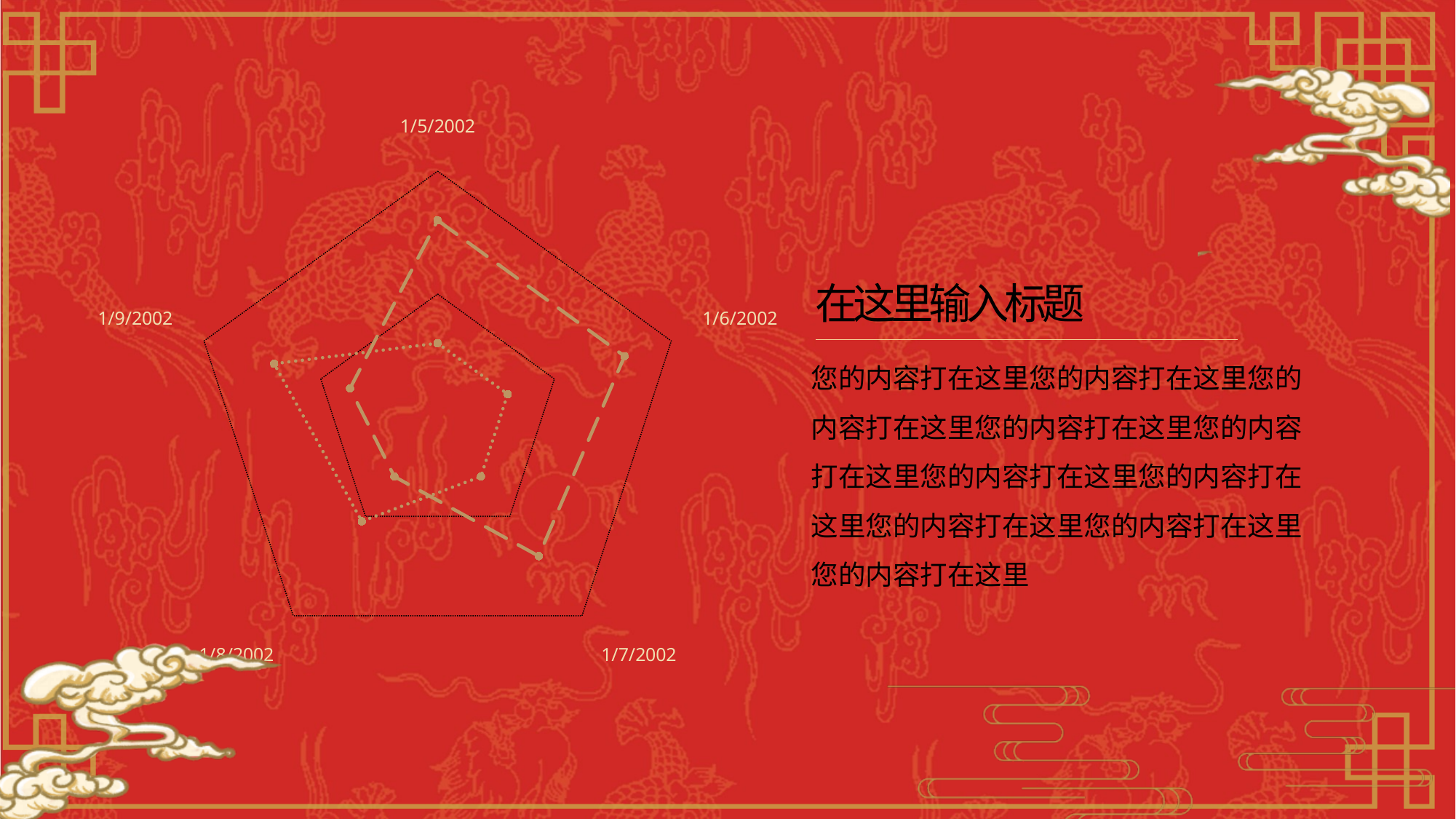
In which category does the dotted-line series reach its highest value? 1/9/2002 For the category 1/8/2002, which series has the larger value: the dashed-line series or the dotted-line series? The dotted-line series For the category 1/5/2002, which series has the larger value: the dashed-line series or the dotted-line series? The dashed-line series How many data series are plotted on the radar chart? 2 For the category 1/9/2002, which series has the larger value: the dashed-line series or the dotted-line series? The dotted-line series How many categories (axes) does the radar chart have? 5 What kind of chart is shown on the slide? Radar chart Which category label appears at the top of the radar chart? 1/5/2002 Which category label is shown at the bottom right of the radar chart? 1/7/2002